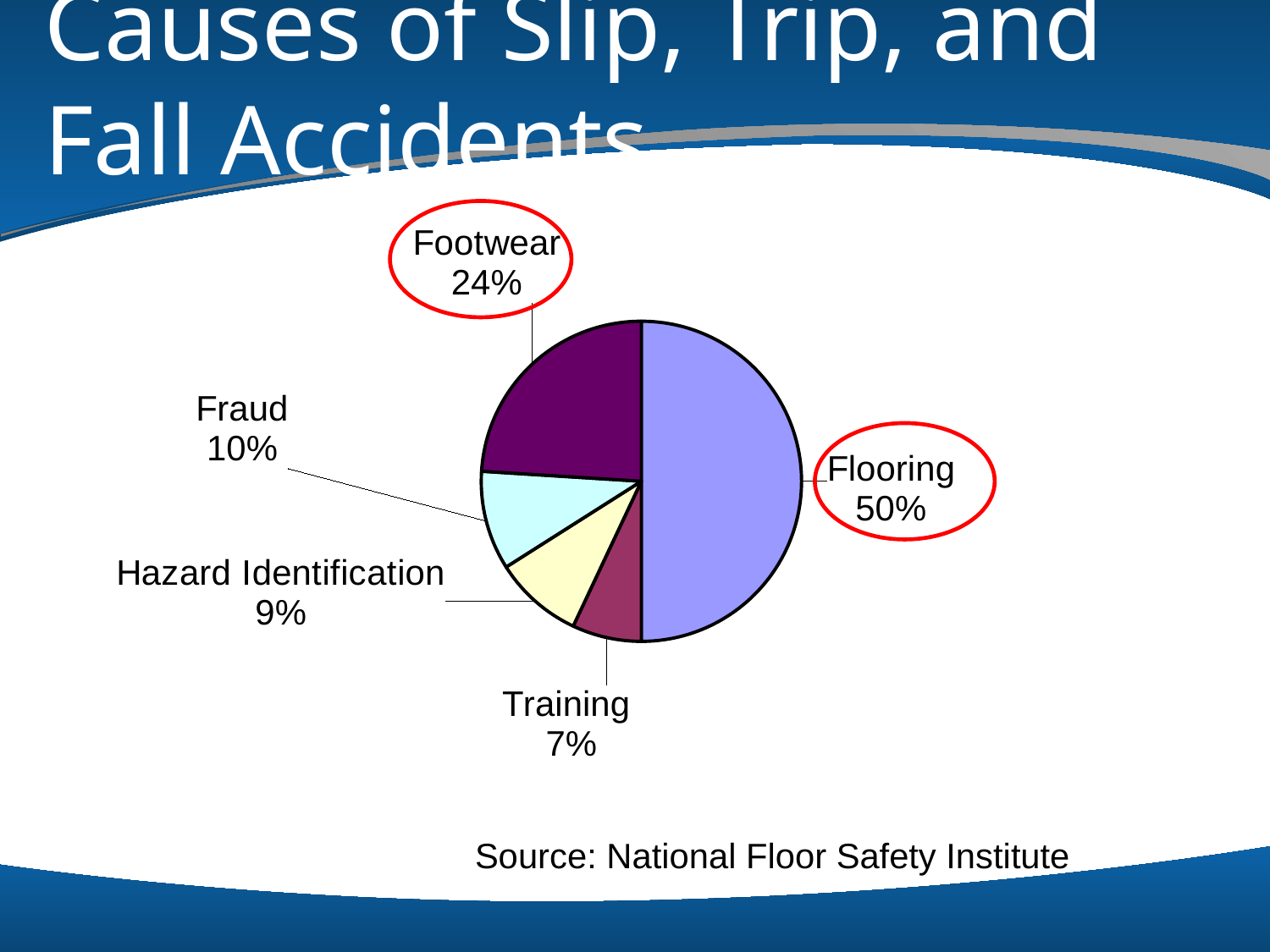
What share of slip, trip, and fall accidents is attributed to Flooring? 50% Which cause has the smallest slice of the pie? Training What percentage of the pie is Footwear? 24% What is the combined share of Fraud and Training? 17% What type of chart is shown on the slide? Pie chart Which two slices are circled in red on the slide? Footwear and Flooring How many causes are shown in the pie chart? 5 What percentage is shown for Hazard Identification? 9% Which cause has the largest slice of the pie? Flooring Which is larger, the Fraud slice or the Hazard Identification slice? Fraud What is the value shown for Training? 7% What is the difference in percentage points between Flooring and Footwear? 26